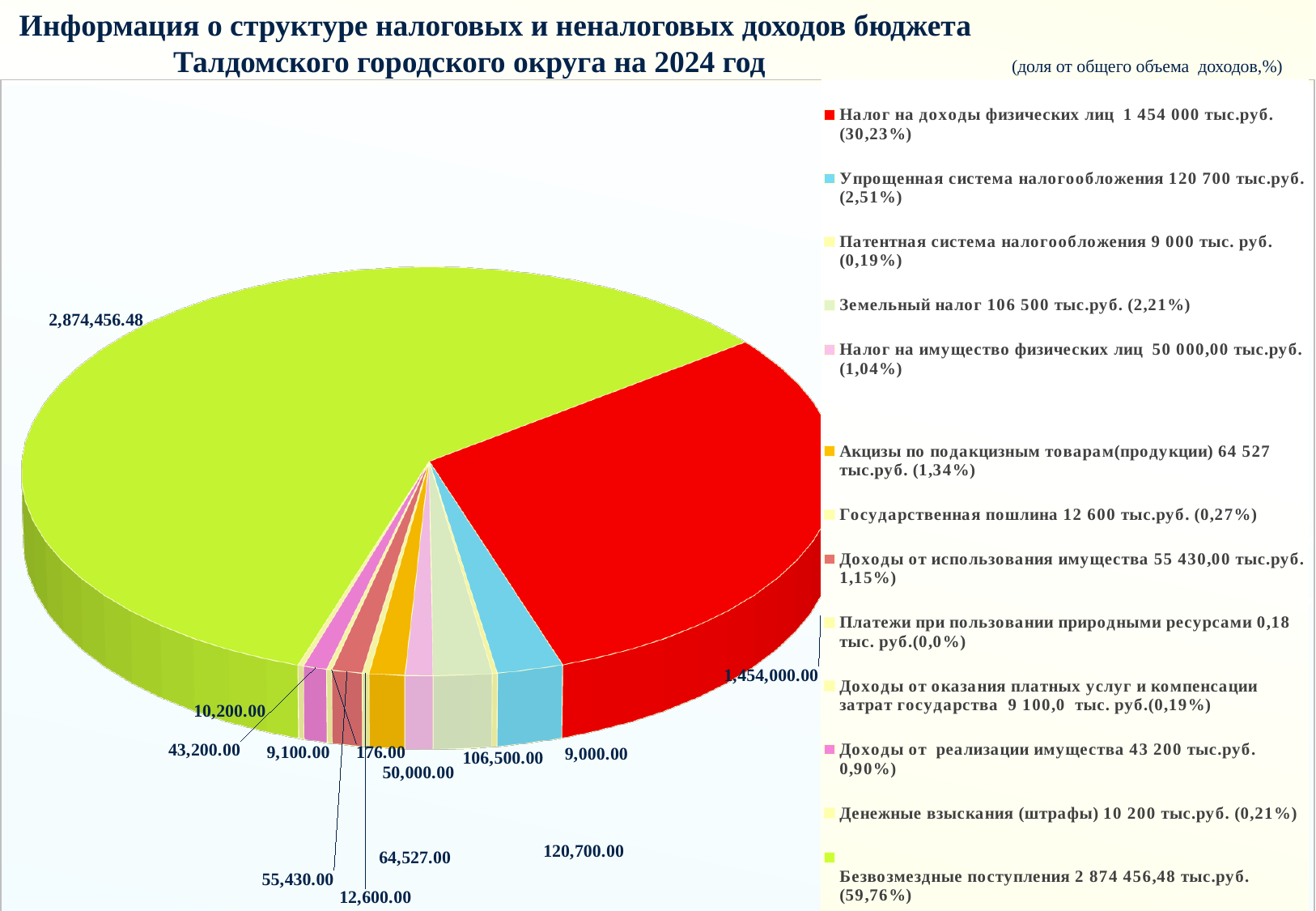
What is the data label value for Земельный налог? 106,500.00 What colour is the slice for Налог на доходы физических лиц? red What is the difference between the data label values for Упрощенная система налогообложения and Земельный налог? 14,200.00 What kind of chart is shown on the slide? pie chart Which is larger: the value for Акцизы по подакцизным товарам or the value for Доходы от использования имущества? Акцизы по подакцизным товарам How many categories (slices) does the pie chart have? 13 What share of total revenue does Безвозмездные поступления represent, according to the legend? 59,76% What is the data label value for Безвозмездные поступления? 2,874,456.48 What share of total revenue does Упрощенная система налогообложения represent, according to the legend? 2,51% Which category has the largest slice of the pie? Безвозмездные поступления What is the data label value for Налог на доходы физических лиц? 1,454,000.00 Which category has the smallest slice of the pie? Платежи при пользовании природными ресурсами